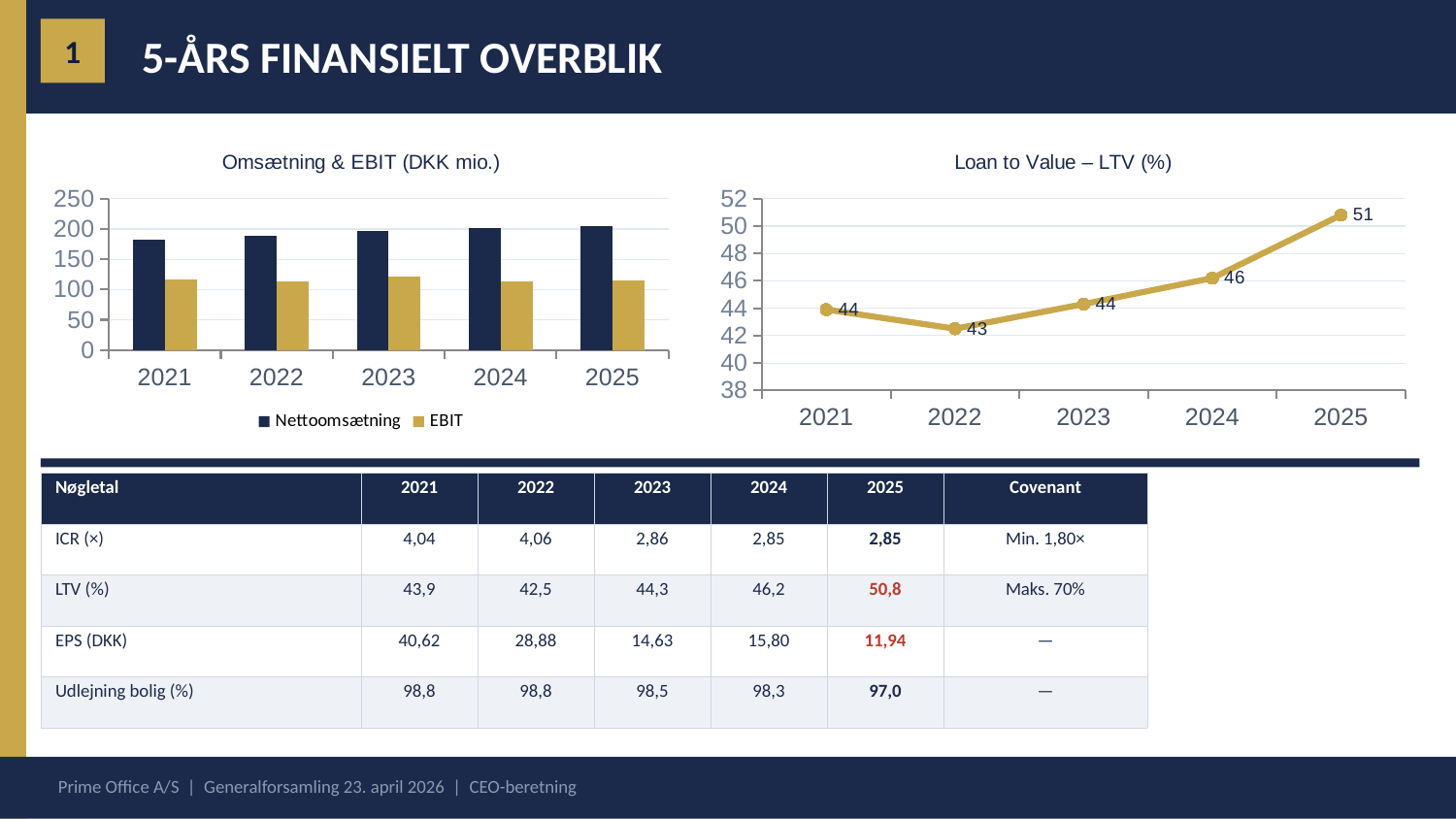
In the Loan to Value – LTV (%) chart, what is the LTV value for 2022? 43 In the Loan to Value – LTV (%) chart, which year has the lowest LTV? 2022 In the Loan to Value – LTV (%) chart, what is the LTV value for 2025? 51 In the Loan to Value – LTV (%) chart, which year has the highest LTV? 2025 In the Omsætning & EBIT (DKK mio.) chart, is the Nettoomsætning value for 2021 greater or less than 150? greater What kind of chart is the Omsætning & EBIT (DKK mio.) chart? bar chart In the Loan to Value – LTV (%) chart, what is the difference between the LTV in 2025 and in 2021? 7 In the Loan to Value – LTV (%) chart, does the LTV rise or fall from 2022 to 2025? rise In the Omsætning & EBIT (DKK mio.) chart, is the EBIT value for 2022 greater or less than 150? less In the Omsætning & EBIT (DKK mio.) chart, how many series does the legend list? 2 What kind of chart is the Loan to Value – LTV (%) chart? line chart In the Loan to Value – LTV (%) chart, how many data points are plotted? 5